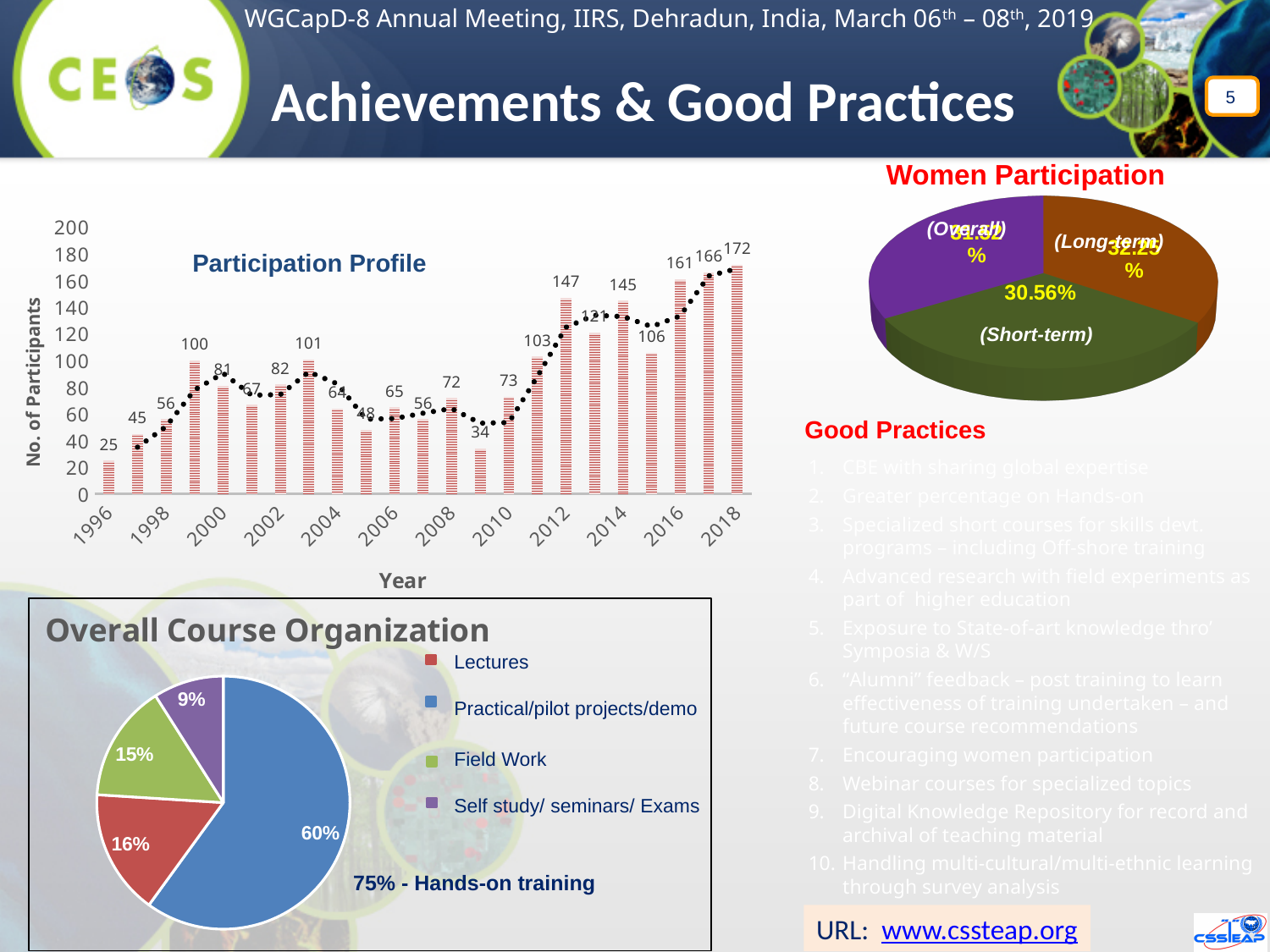
In the Participation Profile chart, which year has the lowest number of participants? 1996 In the Participation Profile chart, which year had more participants, 2012 or 2014? 2012 In the Women Participation chart, what percentage is shown for Short-term? 30.56% In the Participation Profile chart, what is the difference in participants between 2018 and 1996? 147 In the Overall Course Organization chart, which category has the largest share? Practical/pilot projects/demo In the Participation Profile chart, how many participants are shown for 2018? 172 In the Overall Course Organization chart, what share is Field Work? 15% In the Participation Profile chart, how many participants are shown for 2009? 34 What type of chart is the Participation Profile chart? Bar chart How many categories does the legend of the Overall Course Organization chart list? 4 In the Participation Profile chart, how many years are plotted? 23 In the Participation Profile chart, which year has the highest number of participants? 2018